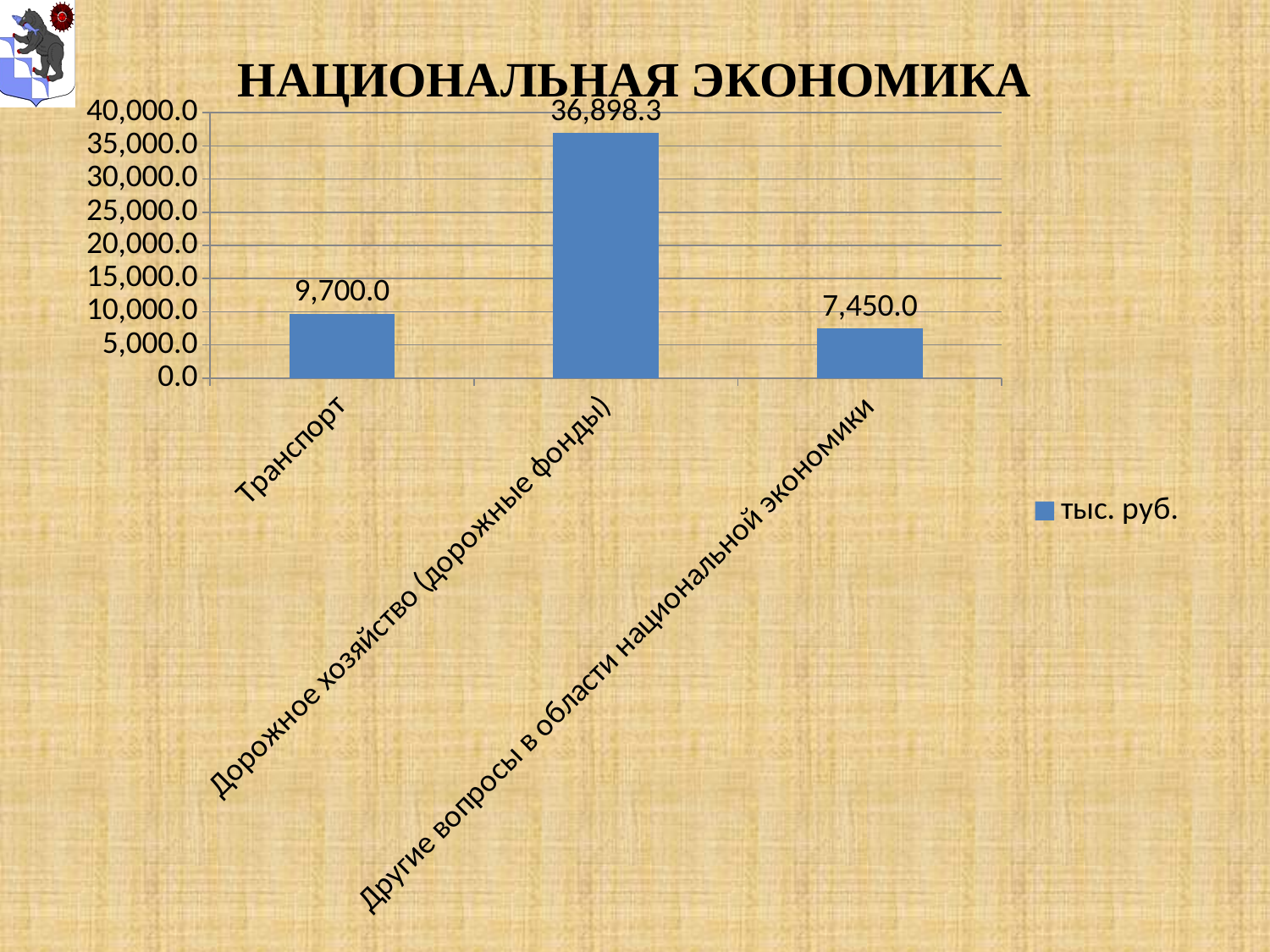
Which category has the lowest value? Другие вопросы в области национальной экономики What is the difference between the values for Дорожное хозяйство (дорожные фонды) and Транспорт? 27,198.3 What is the value for Дорожное хозяйство (дорожные фонды)? 36,898.3 Which is larger, the value for Транспорт or the value for Другие вопросы в области национальной экономики? Транспорт What is the value for Транспорт? 9,700.0 What kind of chart is shown on the slide? bar chart What is the legend entry shown on the chart? тыс. руб. Which category has the highest value? Дорожное хозяйство (дорожные фонды) What is the difference between the values for Транспорт and Другие вопросы в области национальной экономики? 2,250.0 What is the value for Другие вопросы в области национальной экономики? 7,450.0 Is the value for Дорожное хозяйство (дорожные фонды) greater or less than 35,000.0? greater How many categories are shown on the chart? 3